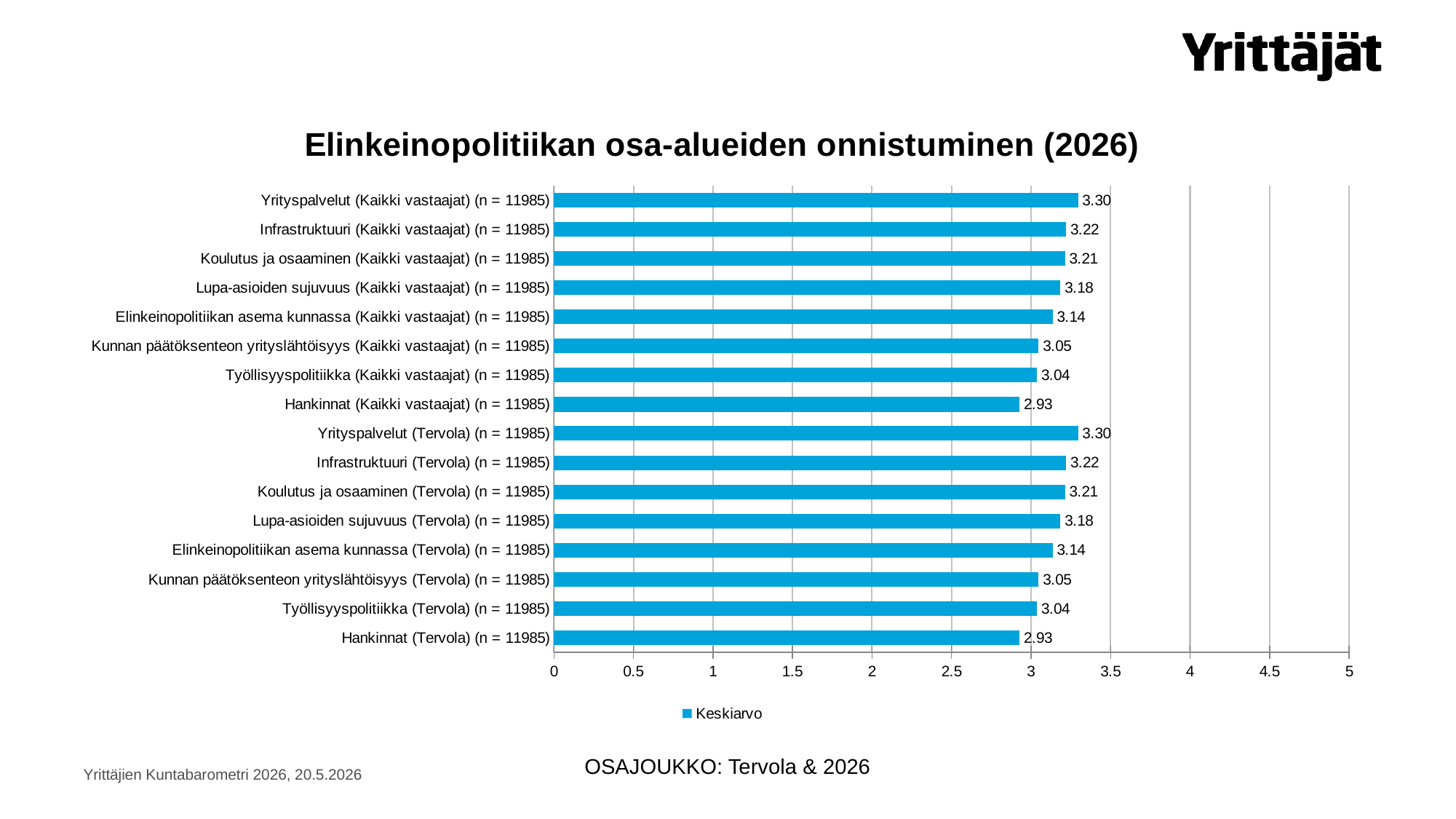
How many bars are shown on the chart? 16 What is the value for Kunnan päätöksenteon yrityslähtöisyys (Tervola) (n = 11985)? 3.05 What is the value for Yrityspalvelut (Kaikki vastaajat) (n = 11985)? 3.30 What is the highest value shown on the chart? 3.30 Is the value for Hankinnat (Kaikki vastaajat) greater or less than 3? less What is the value for Elinkeinopolitiikan asema kunnassa (Kaikki vastaajat) (n = 11985)? 3.14 What is the difference between the values for Yrityspalvelut (Kaikki vastaajat) and Hankinnat (Kaikki vastaajat)? 0.37 What is the lowest value shown on the chart? 2.93 What kind of chart is shown on the slide? bar chart Which is larger: the value for Lupa-asioiden sujuvuus (Tervola) or Työllisyyspolitiikka (Tervola)? Lupa-asioiden sujuvuus (Tervola) How many series does the legend list? 1 What is the value for Hankinnat (Tervola) (n = 11985)? 2.93